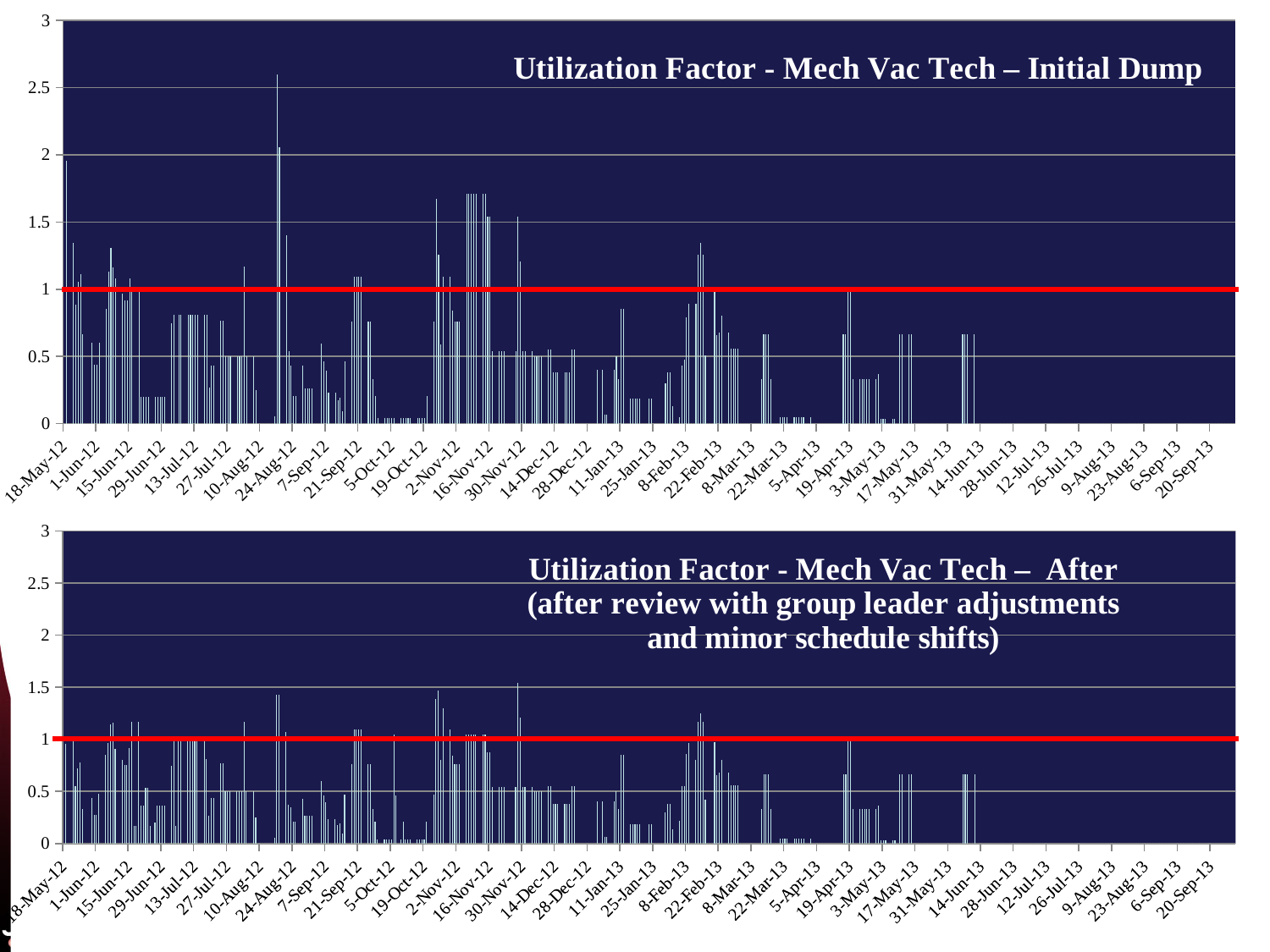
In the top chart (Initial Dump), is the first bar at 18-May-12 greater or less than 1.5? greater In both charts, at what y-axis value is the red horizontal line drawn? 1 What is the first date label on the x axis of the top chart? 18-May-12 What is the title of the top chart on the slide? Utilization Factor - Mech Vac Tech – Initial Dump What is the last date label on the x axis of the bottom chart? 20-Sep-13 Which chart has the higher peak value, the top chart (Initial Dump) or the bottom chart (After)? the top chart (Initial Dump) In the top chart (Initial Dump), are the tall bars near 16-Nov-12 greater or less than 1.5? greater What kind of chart is the top chart, 'Utilization Factor - Mech Vac Tech – Initial Dump'? bar chart In the bottom chart (After), is the tall bar near 24-Aug-12 greater or less than 1? greater